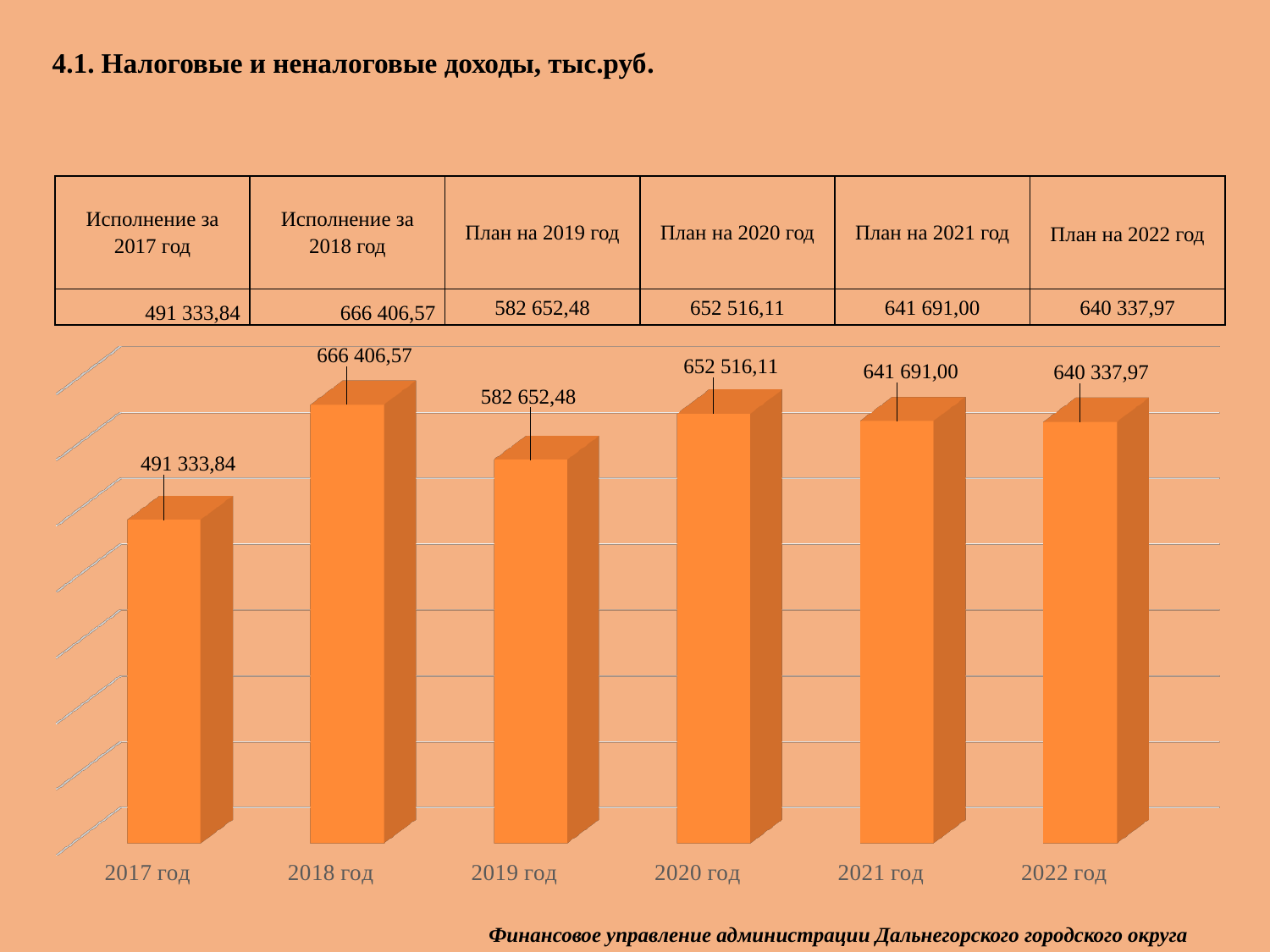
In what units are the values on the slide given, according to the slide title? тыс.руб. Which year has the highest value? 2018 год What is the value for 2017 год? 491 333,84 How many years are shown on the chart? 6 Which is larger, the value for 2019 год or the value for 2020 год? 2020 год What is the value for 2020 год? 652 516,11 Does the value rise or fall from 2017 год to 2018 год? rise Which year has the lowest value? 2017 год What kind of chart is shown on the slide? bar chart What is the difference between the values for 2020 год and 2019 год? 69 863,63 What is the difference between the values for 2018 год and 2017 год? 175 072,73 What is the value for 2022 год? 640 337,97